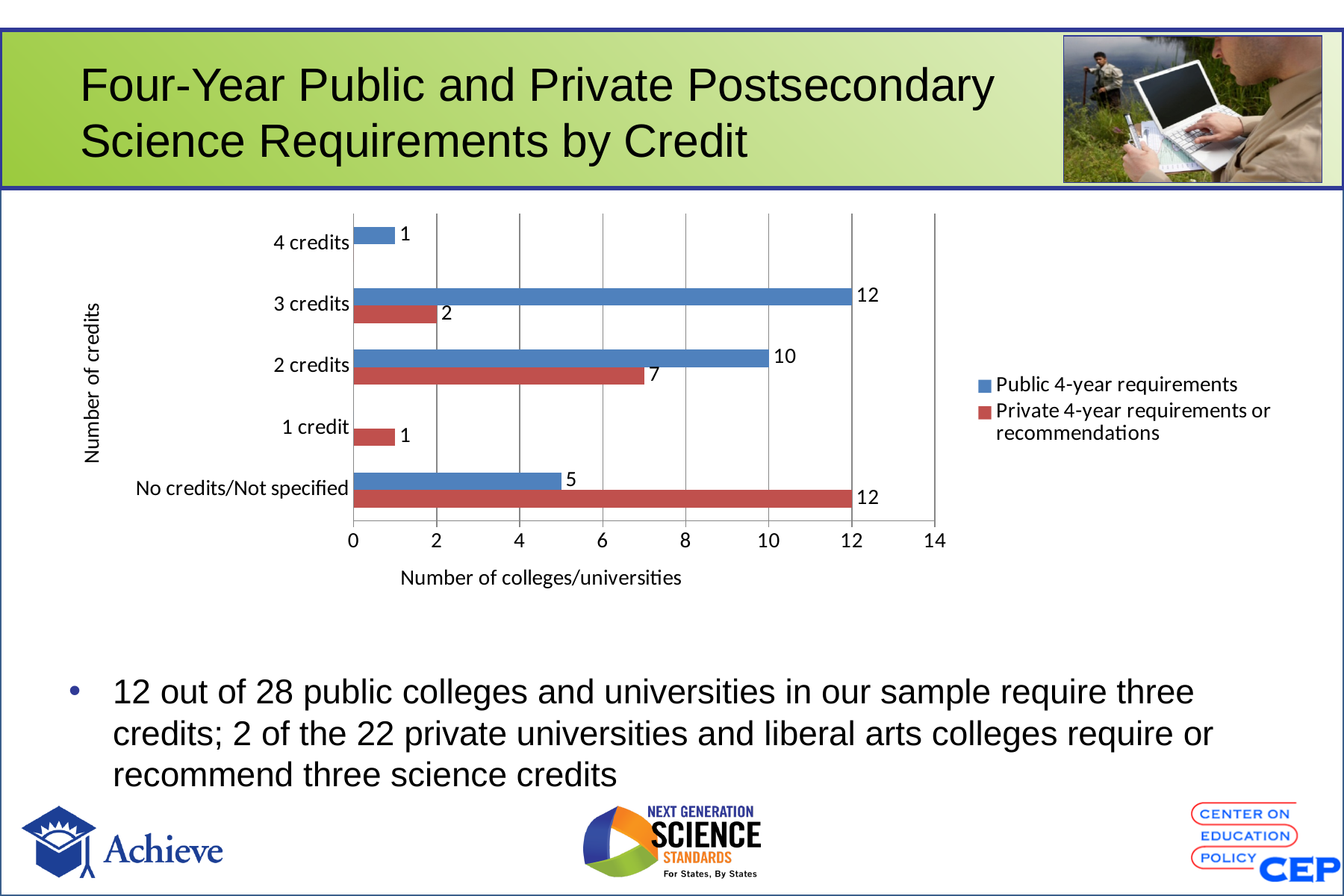
What is the value for Public 4-year requirements at No credits/Not specified? 5 What is the value for Private 4-year requirements or recommendations at 2 credits? 7 What is the value for Public 4-year requirements at 4 credits? 1 What is the x-axis title of the chart? Number of colleges/universities What is the value for Public 4-year requirements at 3 credits? 12 What kind of chart is shown on the slide? Bar chart How many credit categories are shown on the y axis? 5 How many series does the legend list? 2 Which is larger at No credits/Not specified: Public 4-year requirements or Private 4-year requirements or recommendations? Private 4-year requirements or recommendations Which category has the highest value for Public 4-year requirements? 3 credits Which category has the highest value for Private 4-year requirements or recommendations? No credits/Not specified What is the difference between the Public and Private values at 2 credits? 3